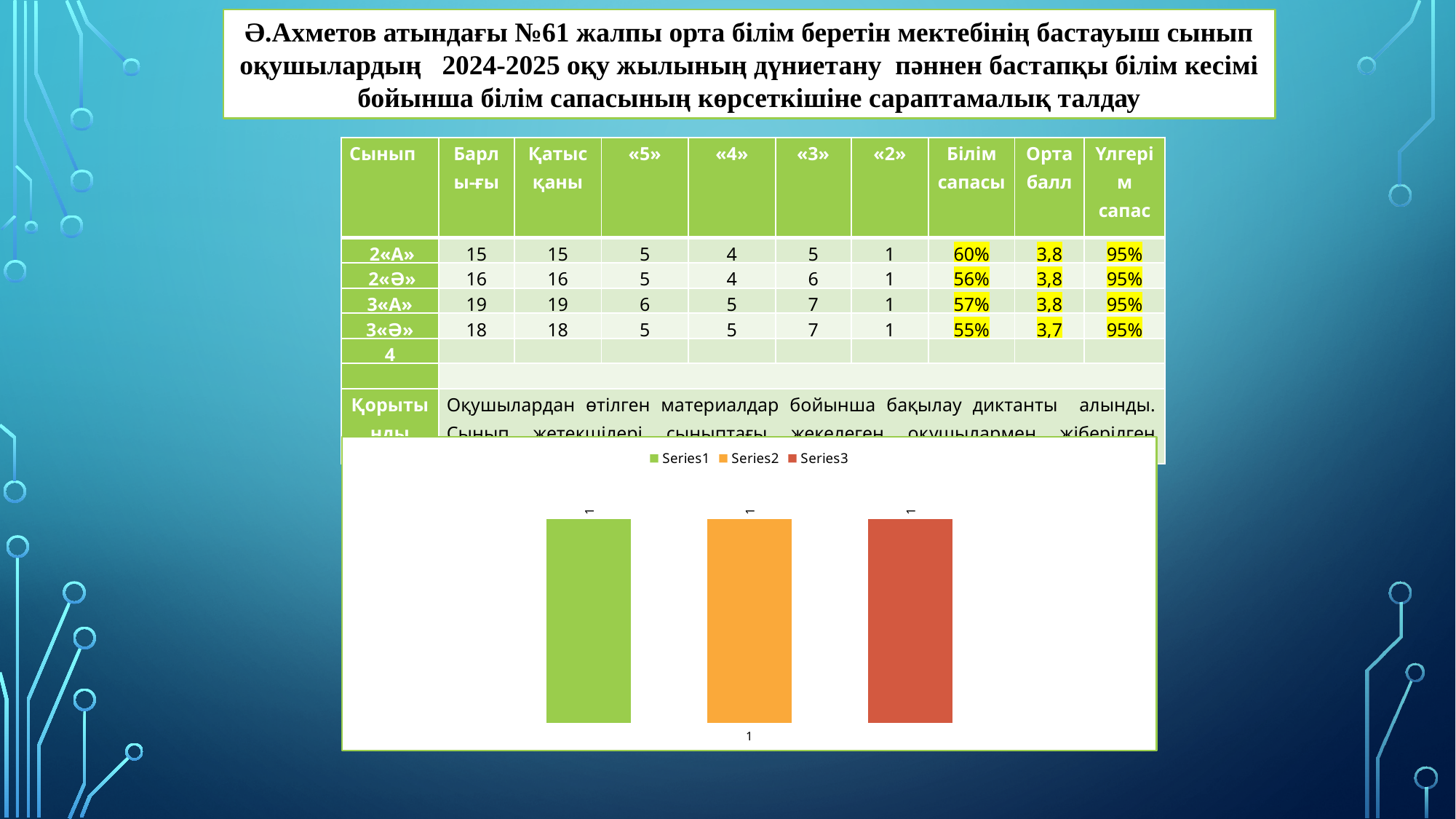
What is the label of the single category on the x axis of the chart? 1 What is the value of Series2 in the chart? 1 How many series does the chart legend list? 3 What is the difference between the values of Series1 and Series3 in the chart? 0 How many categories are plotted on the x axis of the chart? 1 What kind of chart is shown on the slide? bar chart What is the value of Series1 in the chart? 1 What is the value of Series3 in the chart? 1 What colour is the Series2 bar in the chart? orange